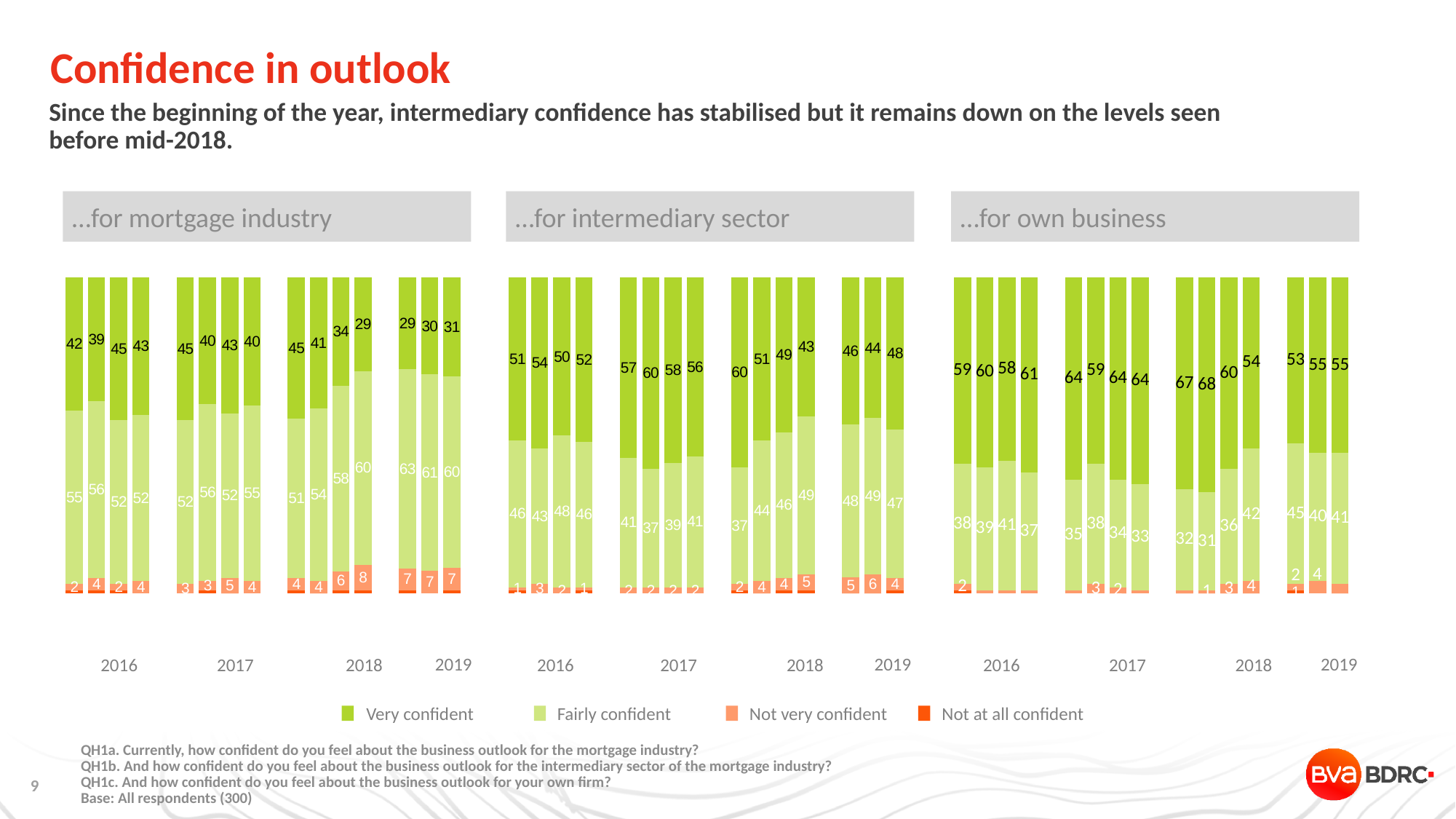
How many bars are plotted in the '...for own business' chart? 15 For the last bar of 2019, which chart shows the larger 'Very confident' value: '...for own business' or '...for mortgage industry'? ...for own business In the '...for mortgage industry' chart, what is the 'Very confident' value for the first bar of 2016? 42 In the '...for own business' chart, what is the 'Fairly confident' value for the last bar of 2018? 42 How many series does the legend list? 4 What kind of chart is used in the '...for mortgage industry' panel? Stacked bar chart In the '...for own business' chart, what is the highest 'Very confident' value shown? 68 In the '...for mortgage industry' chart, what is the difference between the 'Very confident' value of the first bar of 2016 (42) and the last bar of 2019 (31)? 11 In the '...for mortgage industry' chart, do the 'Very confident' values generally rise or fall from 2016 to 2019? Fall In the '...for mortgage industry' chart, what is the highest 'Fairly confident' value shown? 63 In the '...for intermediary sector' chart, what is the 'Very confident' value for the first bar of 2018? 60 Which legend entry is shown in the darkest green colour? Very confident